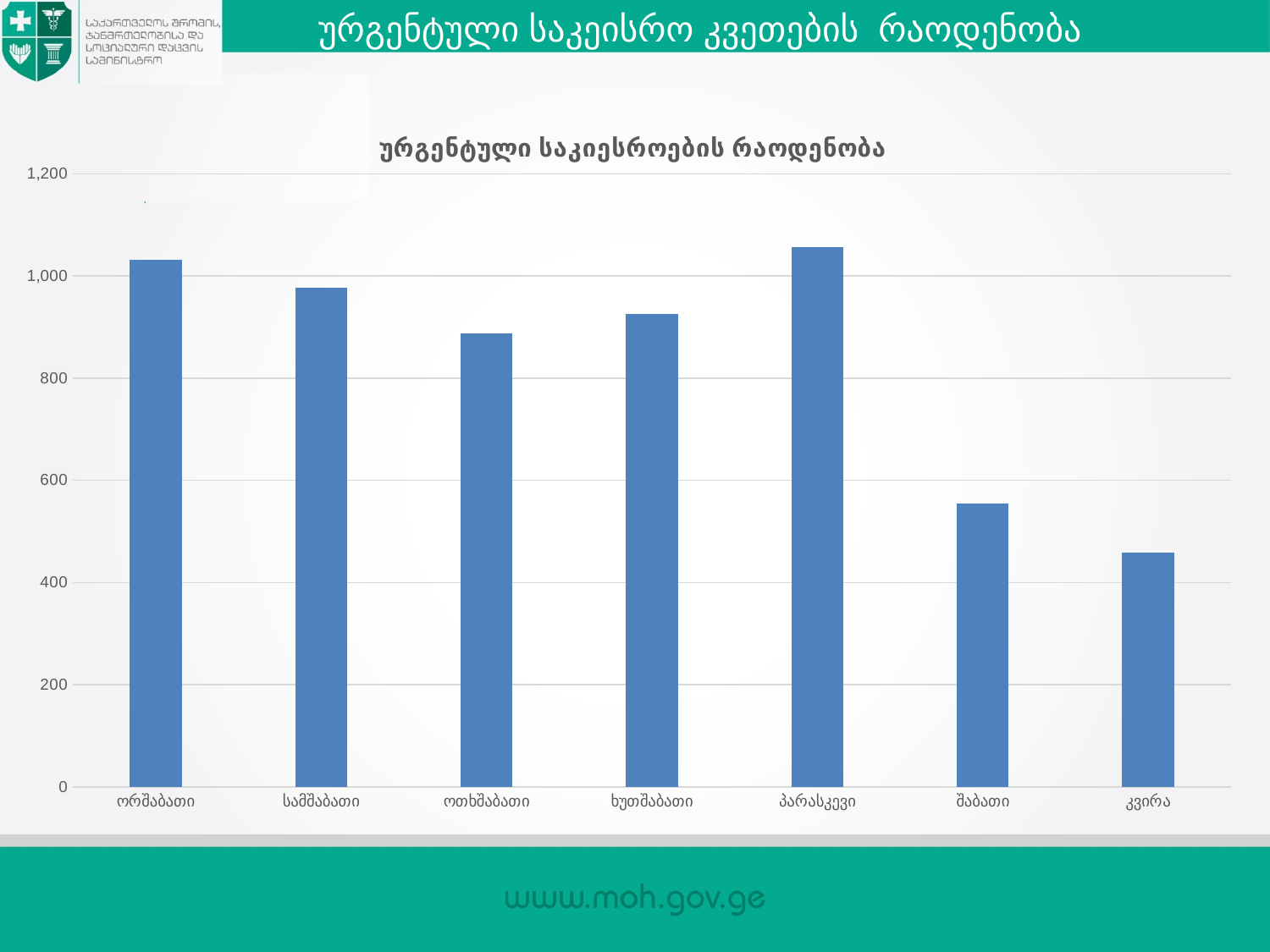
How many categories are shown on the x axis of the chart? 7 Is the value for ორშაბათი greater or less than 1,000? greater Is the value for სამშაბათი greater or less than 800? greater Is the value for ოთხშაბათი greater or less than 1,000? less Which category has the lowest bar in the chart? კვირა Which category has the highest bar in the chart? პარასკევი What kind of chart is shown on the slide? bar chart What is the title of the chart? ურგენტული საკიესროების რაოდენობა Which is larger, the value for სამშაბათი or the value for ოთხშაბათი? სამშაბათი Which is larger, the value for შაბათი or the value for კვირა? შაბათი